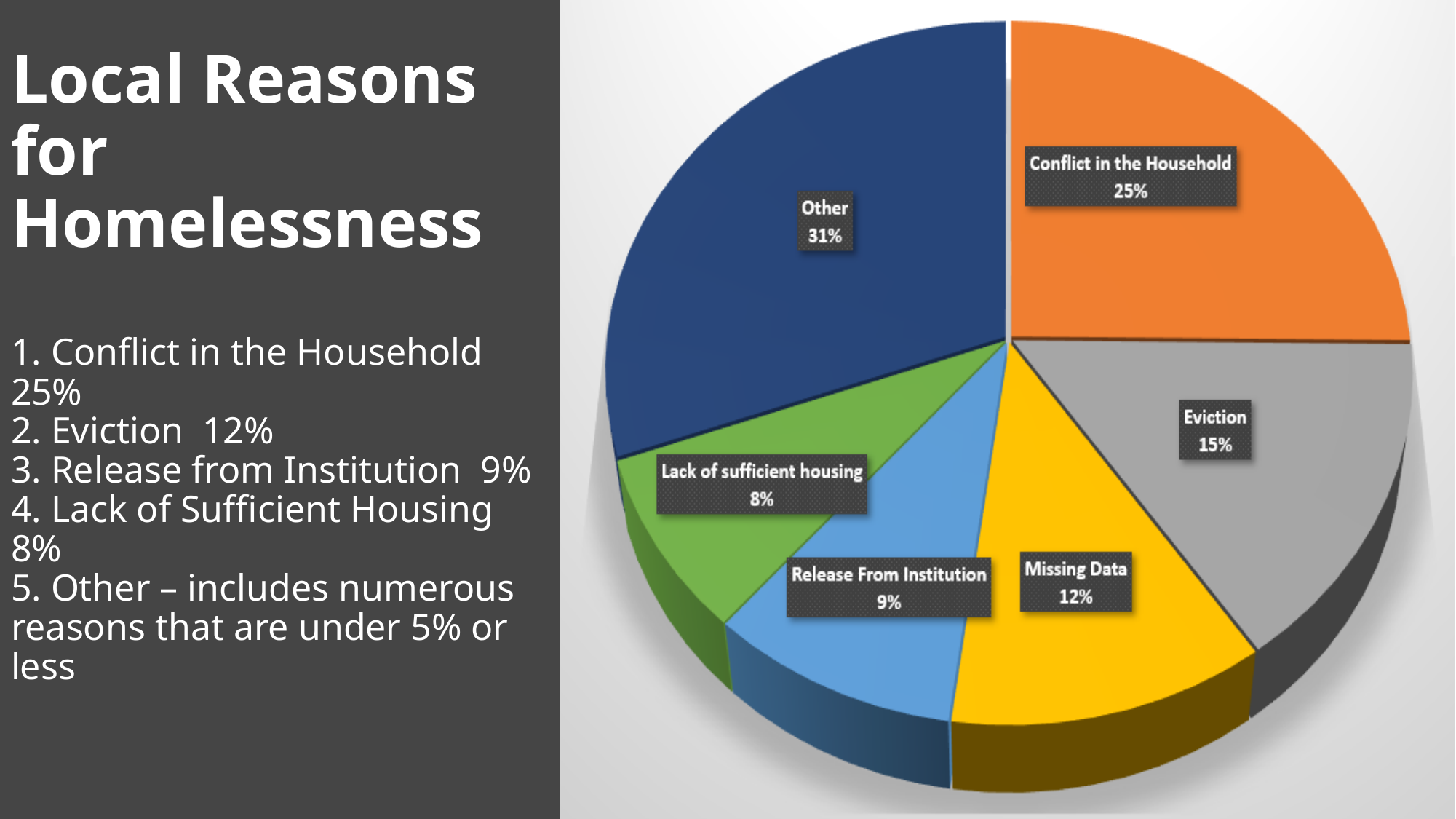
What is the difference in percentage points between the Other slice and the Conflict in the Household slice? 6 What kind of chart is shown on the slide? pie chart What percentage does the pie chart show for Other? 31% What percentage does the pie chart label show for Eviction? 15% What colour is the Conflict in the Household slice in the pie chart? orange Which is larger in the pie chart, Missing Data or Release From Institution? Missing Data What percentage does the pie chart show for Conflict in the Household? 25% Which slice of the pie chart is the smallest? Lack of sufficient housing What percentage does the pie chart show for Release From Institution? 9% What percentage does the pie chart show for Missing Data? 12% Which slice of the pie chart is the largest? Other How many slices does the pie chart have? 6